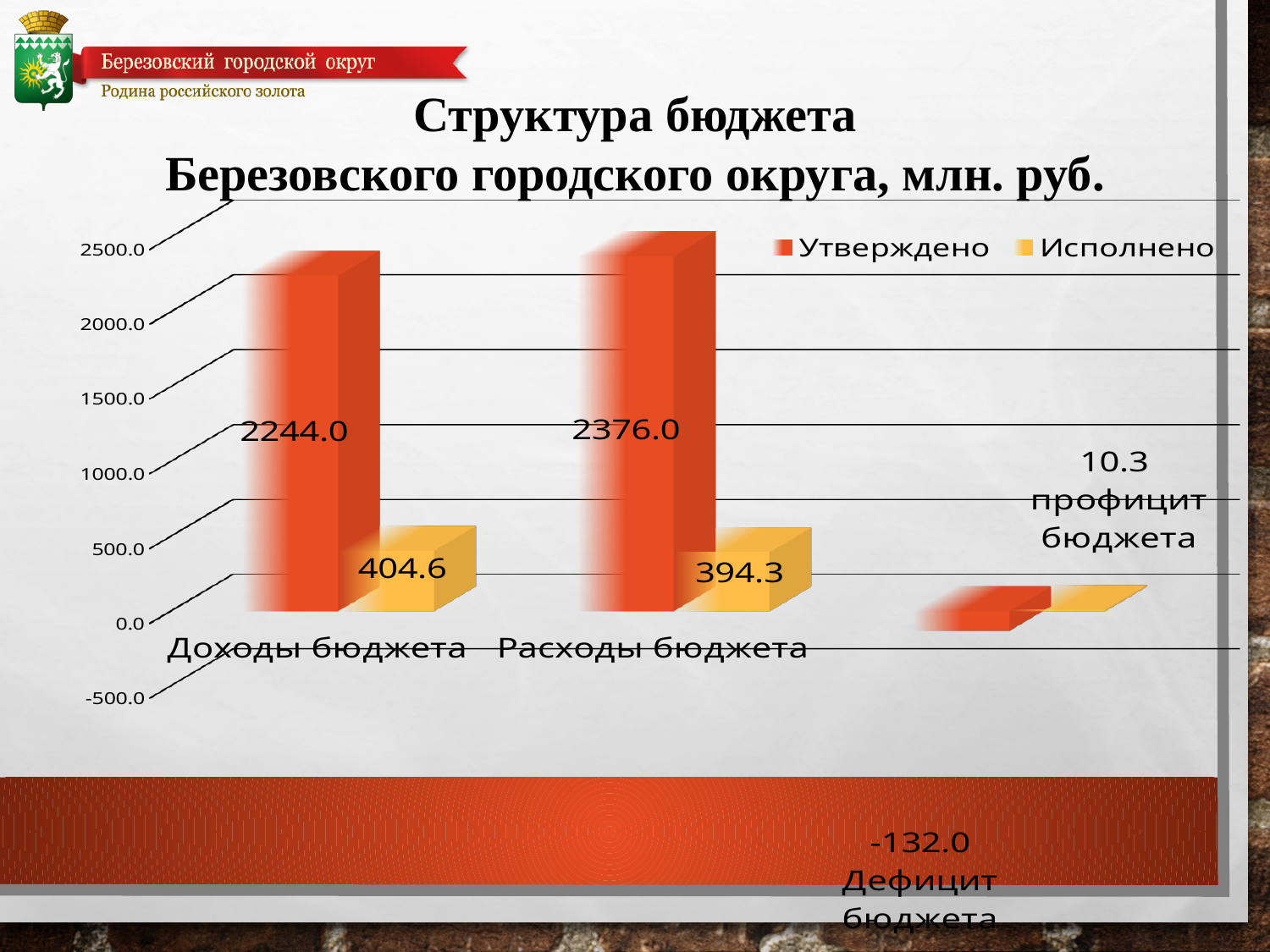
What value is labelled 'профицит бюджета' on the chart? 10.3 What is the difference between the approved values for Расходы бюджета and Доходы бюджета? 132.0 How many series does the legend list? 2 What is the approved (Утверждено) value for Доходы бюджета? 2244.0 What value is labelled 'Дефицит бюджета' on the chart? -132.0 What is the executed (Исполнено) value for Расходы бюджета? 394.3 Which is larger: the approved value for Доходы бюджета or the approved value for Расходы бюджета? Расходы бюджета What kind of chart is shown on the slide? Bar chart What is the approved (Утверждено) value for Расходы бюджета? 2376.0 What is the executed (Исполнено) value for Доходы бюджета? 404.6 What is the unit of measurement given in the chart title? млн. руб. What is the difference between the executed values for Доходы бюджета and Расходы бюджета? 10.3